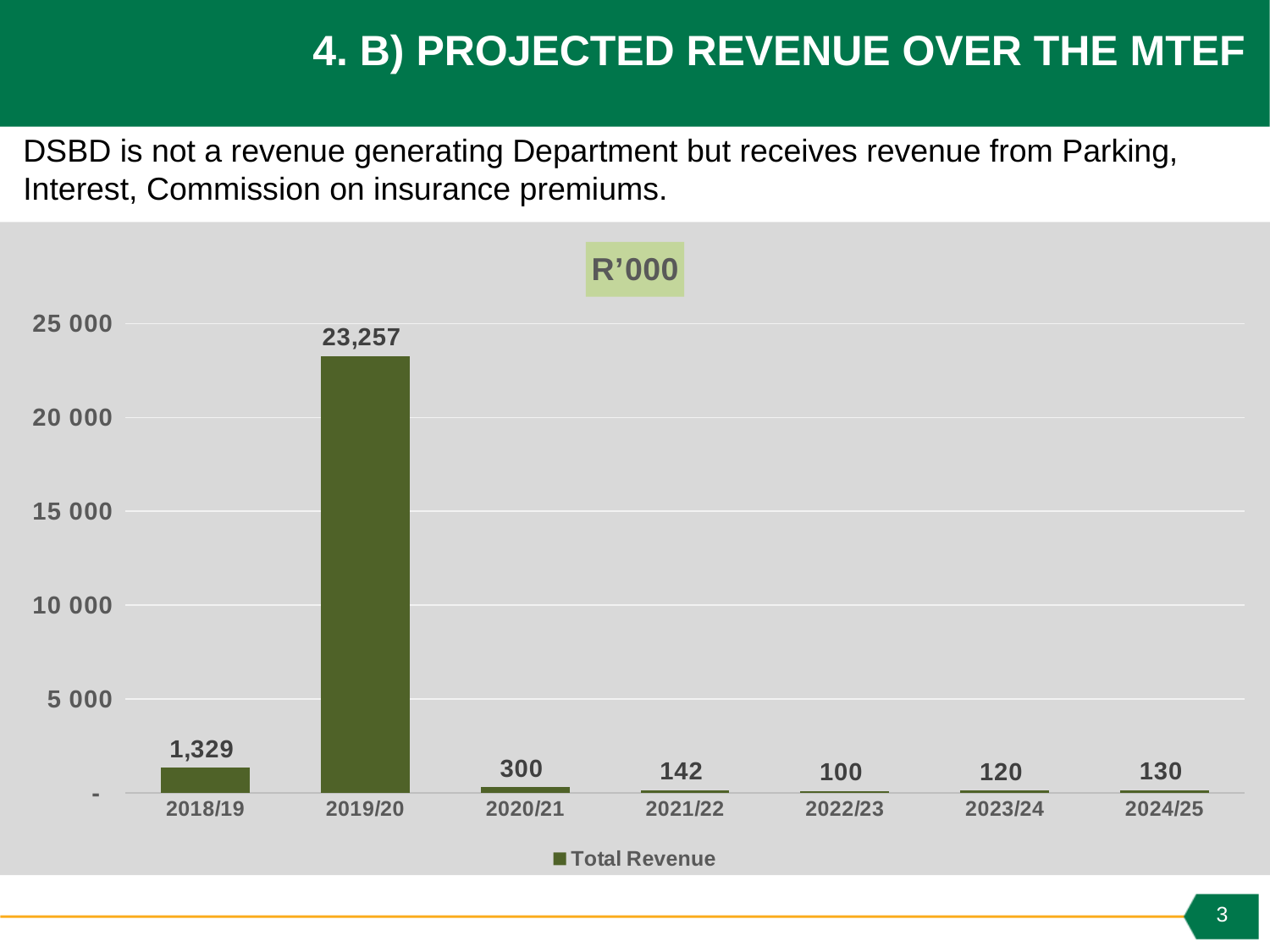
How many years are shown on the x axis of the chart? 7 What is the difference between the Total Revenue for 2019/20 and 2018/19? 21,928 What is the Total Revenue value for 2018/19? 1,329 Which is larger, the Total Revenue for 2023/24 or for 2024/25? 2024/25 Which year has the highest Total Revenue? 2019/20 What is the unit label shown above the chart? R'000 What is the Total Revenue value for 2021/22? 142 What is the Total Revenue value for 2024/25? 130 What is the difference between the Total Revenue for 2020/21 and 2021/22? 158 What is the Total Revenue value for 2019/20? 23,257 Which year has the lowest Total Revenue? 2022/23 What kind of chart is shown on the slide? Bar chart